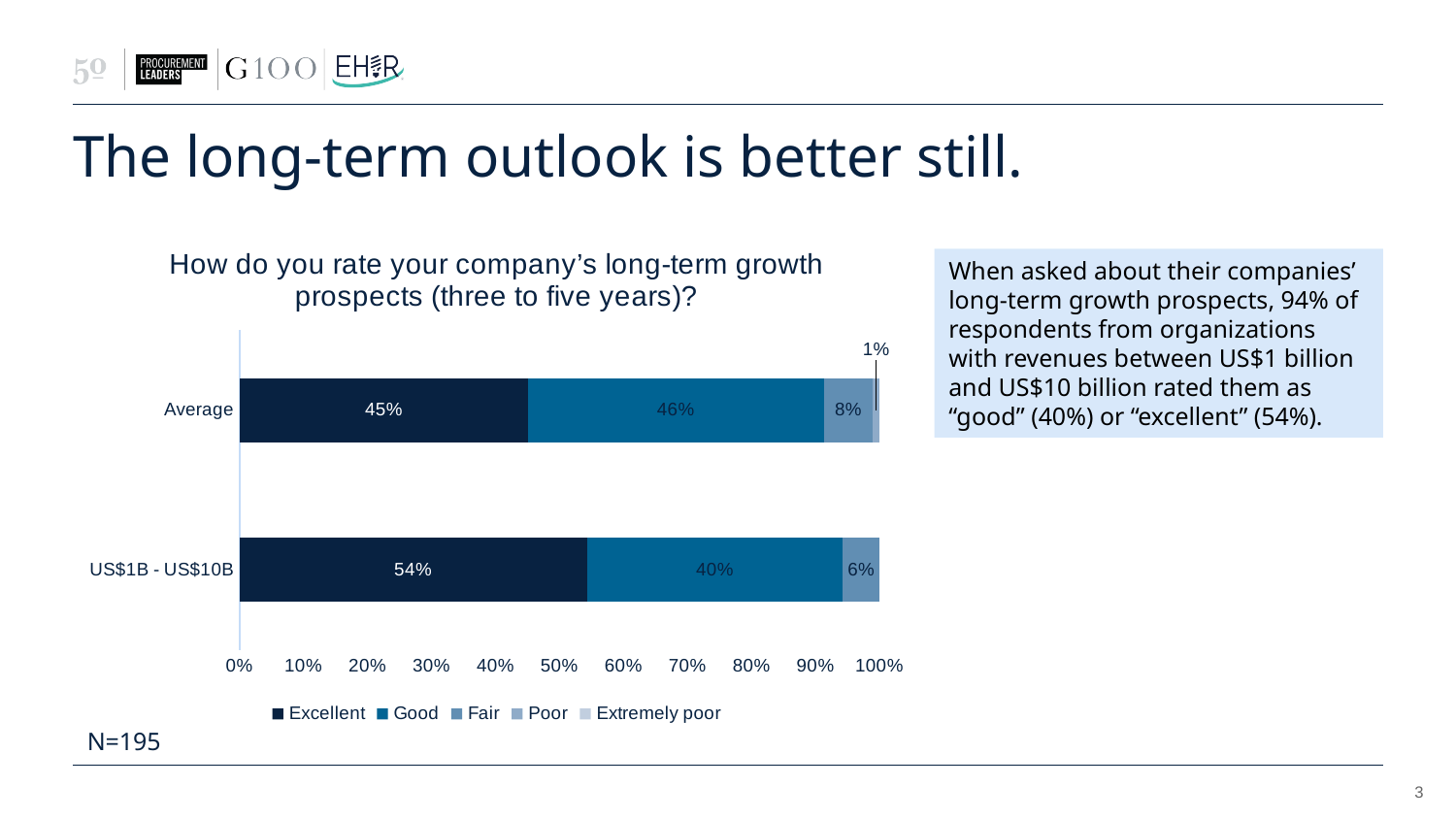
How many categories are shown on the y axis? 2 What is the combined "Excellent" and "Good" share for the US$1B - US$10B category? 94% What is the "Fair" value for the Average category? 8% What is the difference between the "Excellent" values for US$1B - US$10B and Average? 9% What is the "Fair" value for the US$1B - US$10B category? 6% What is the title of the chart? How do you rate your company's long-term growth prospects (three to five years)? Which category has the higher "Excellent" value, Average or US$1B - US$10B? US$1B - US$10B How many series does the legend list? 5 What is the "Excellent" value for the US$1B - US$10B category? 54% What is the "Good" value for the US$1B - US$10B category? 40% What is the "Excellent" value for the Average category? 45% What kind of chart is shown on the slide? Stacked bar chart